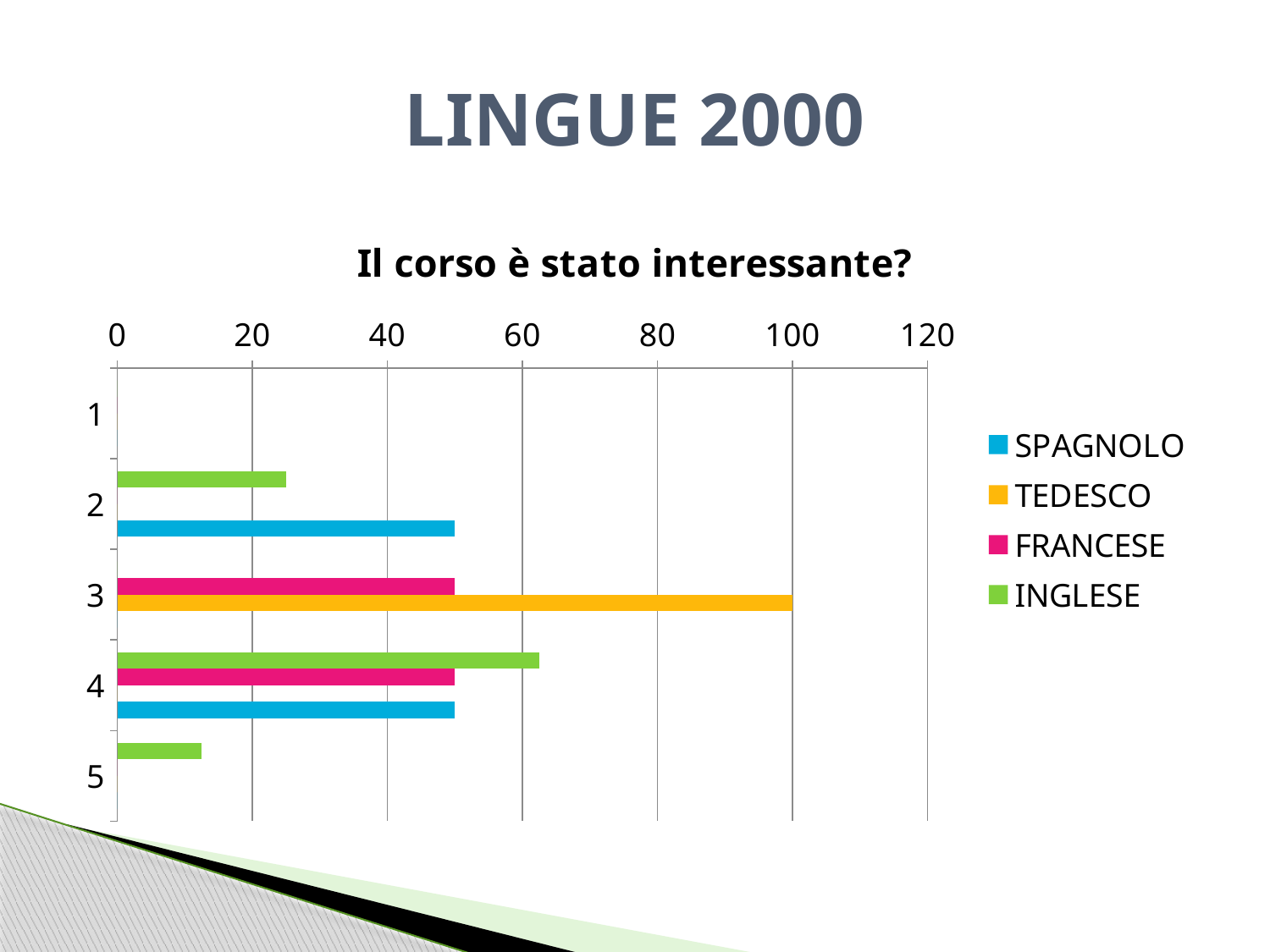
How many series does the legend list? 4 Is the value of INGLESE for category 2 greater or less than 40? less What is the value of TEDESCO for category 3? 100 What is the title of the chart? Il corso è stato interessante? Which series has the longest bar in the chart? TEDESCO For category 3, which is larger: TEDESCO or FRANCESE? TEDESCO For category 4, which is larger: INGLESE or SPAGNOLO? INGLESE Is the value of SPAGNOLO for category 2 greater or less than 40? greater How many categories are shown on the vertical axis? 5 What kind of chart is shown on the slide? bar chart Is the value of INGLESE for category 5 greater or less than 20? less